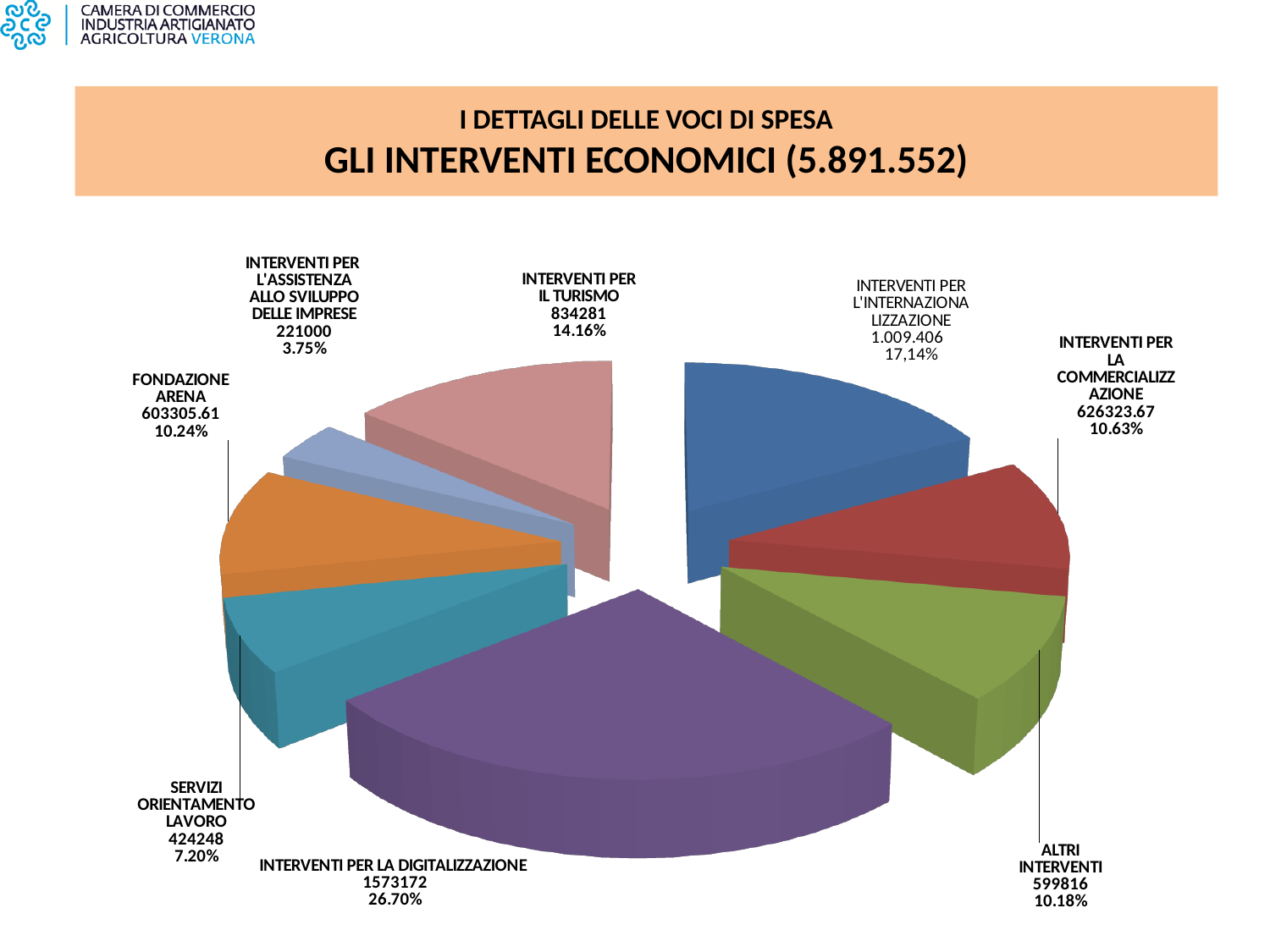
What percentage share is shown for INTERVENTI PER L'INTERNAZIONALIZZAZIONE? 17,14% What value is shown for FONDAZIONE ARENA? 603305.61 What kind of chart is shown on the slide? Pie chart Which category has the smallest slice of the pie? INTERVENTI PER L'ASSISTENZA ALLO SVILUPPO DELLE IMPRESE Which is larger, the value for SERVIZI ORIENTAMENTO LAVORO or the value for ALTRI INTERVENTI? ALTRI INTERVENTI What is the difference in percentage share between INTERVENTI PER LA DIGITALIZZAZIONE and INTERVENTI PER IL TURISMO? 12.54% What percentage share is shown for INTERVENTI PER IL TURISMO? 14.16% Which category has the largest slice of the pie? INTERVENTI PER LA DIGITALIZZAZIONE How many slices does the pie chart have? 8 What is the difference between the value for INTERVENTI PER IL TURISMO and the value for ALTRI INTERVENTI? 234465 What total amount is shown in parentheses in the slide title? 5.891.552 What value is shown for INTERVENTI PER LA DIGITALIZZAZIONE? 1573172